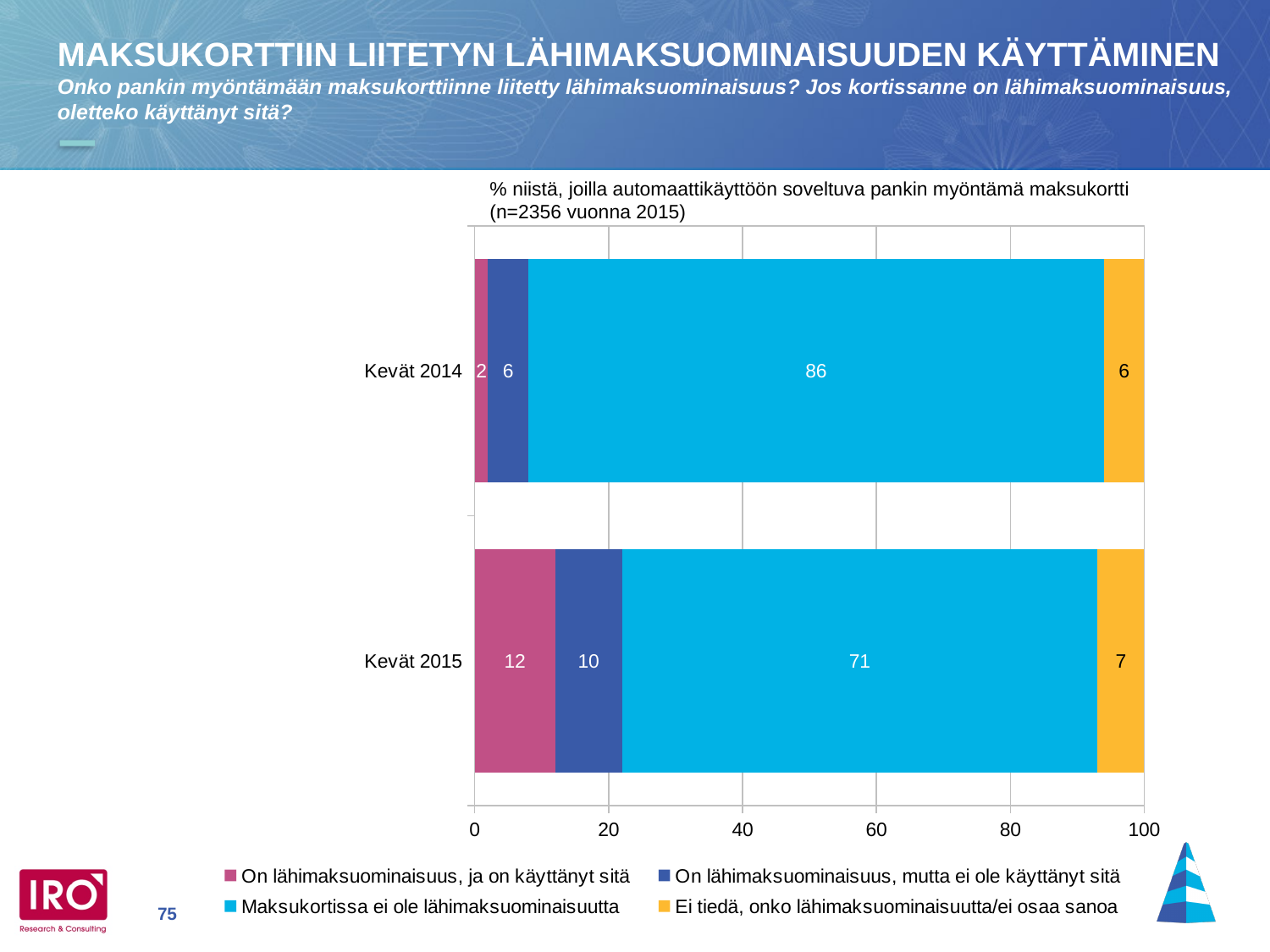
How many series does the legend list? 4 What is the value for 'On lähimaksuominaisuus, mutta ei ole käyttänyt sitä' for Kevät 2014? 6 What is the difference between the 'Maksukortissa ei ole lähimaksuominaisuutta' values for Kevät 2014 and Kevät 2015? 15 What is the value for 'Maksukortissa ei ole lähimaksuominaisuutta' for Kevät 2014? 86 How many categories are plotted on the chart? 2 What is the value for 'On lähimaksuominaisuus, ja on käyttänyt sitä' for Kevät 2015? 12 What kind of chart is shown on the slide? Stacked bar chart Which series has the highest value for Kevät 2015? Maksukortissa ei ole lähimaksuominaisuutta Which series has the lowest value for Kevät 2014? On lähimaksuominaisuus, ja on käyttänyt sitä Which year has the larger value for 'On lähimaksuominaisuus, ja on käyttänyt sitä', Kevät 2014 or Kevät 2015? Kevät 2015 What is the total of the stacked bar for Kevät 2015? 100 What is the value for 'Ei tiedä, onko lähimaksuominaisuutta/ei osaa sanoa' for Kevät 2015? 7